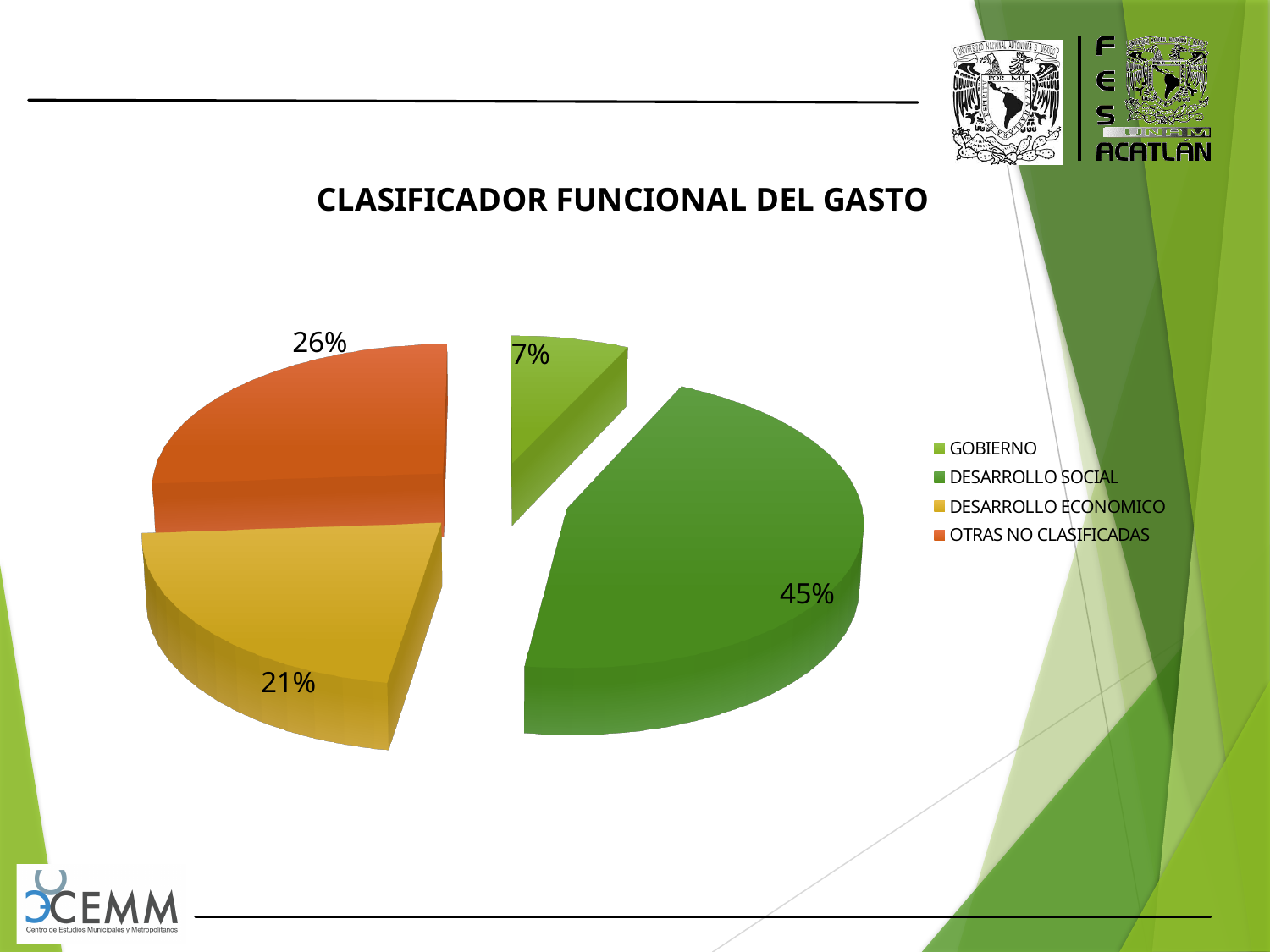
What colour represents OTRAS NO CLASIFICADAS in the chart? Orange What percentage is shown for GOBIERNO? 7% What type of chart is shown on the slide? Pie chart What percentage is shown for DESARROLLO ECONOMICO? 21% How many categories does the legend list? 4 Which category has the smallest share of the pie? GOBIERNO What is the title of the chart? CLASIFICADOR FUNCIONAL DEL GASTO Which category has the largest share of the pie? DESARROLLO SOCIAL What is the difference in percentage points between DESARROLLO SOCIAL and OTRAS NO CLASIFICADAS? 19 What percentage is shown for DESARROLLO SOCIAL? 45% Which is larger, the share for OTRAS NO CLASIFICADAS or the share for DESARROLLO ECONOMICO? OTRAS NO CLASIFICADAS What percentage is shown for OTRAS NO CLASIFICADAS? 26%